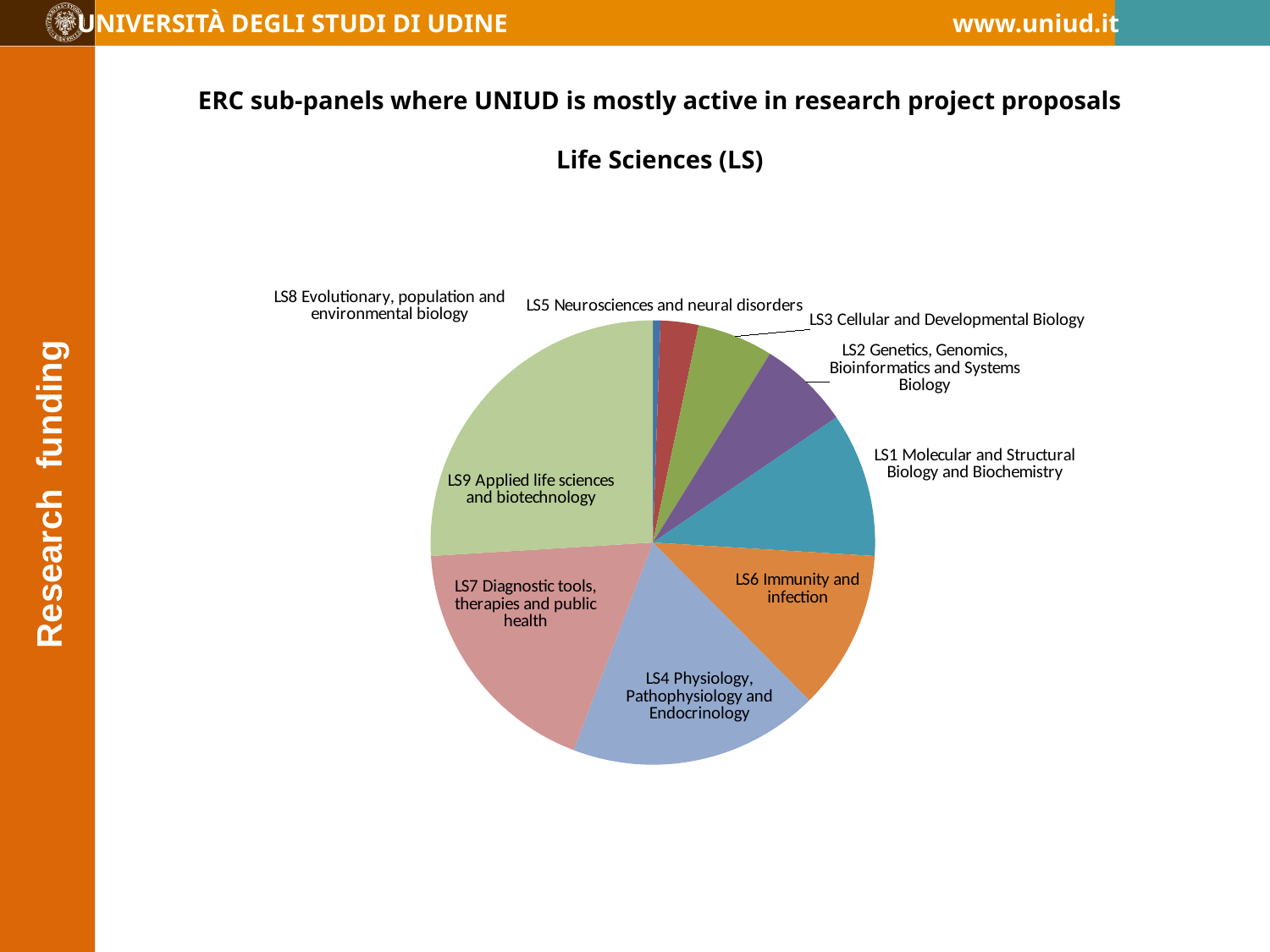
Which slice is larger: LS7 Diagnostic tools, therapies and public health or LS5 Neurosciences and neural disorders? LS7 Diagnostic tools, therapies and public health Which ERC sub-panel has the smallest slice of the pie chart? LS8 Evolutionary, population and environmental biology Which slice is larger: LS4 Physiology, Pathophysiology and Endocrinology or LS6 Immunity and infection? LS4 Physiology, Pathophysiology and Endocrinology How many ERC sub-panel slices does the pie chart contain? 9 Which slice is larger: LS6 Immunity and infection or LS3 Cellular and Developmental Biology? LS6 Immunity and infection What kind of chart is shown on the slide? pie chart Which ERC sub-panel has the largest slice of the pie chart? LS9 Applied life sciences and biotechnology What colour is the slice for LS9 Applied life sciences and biotechnology? light green Which scientific domain does the pie chart cover, according to the subtitle above it? Life Sciences (LS)